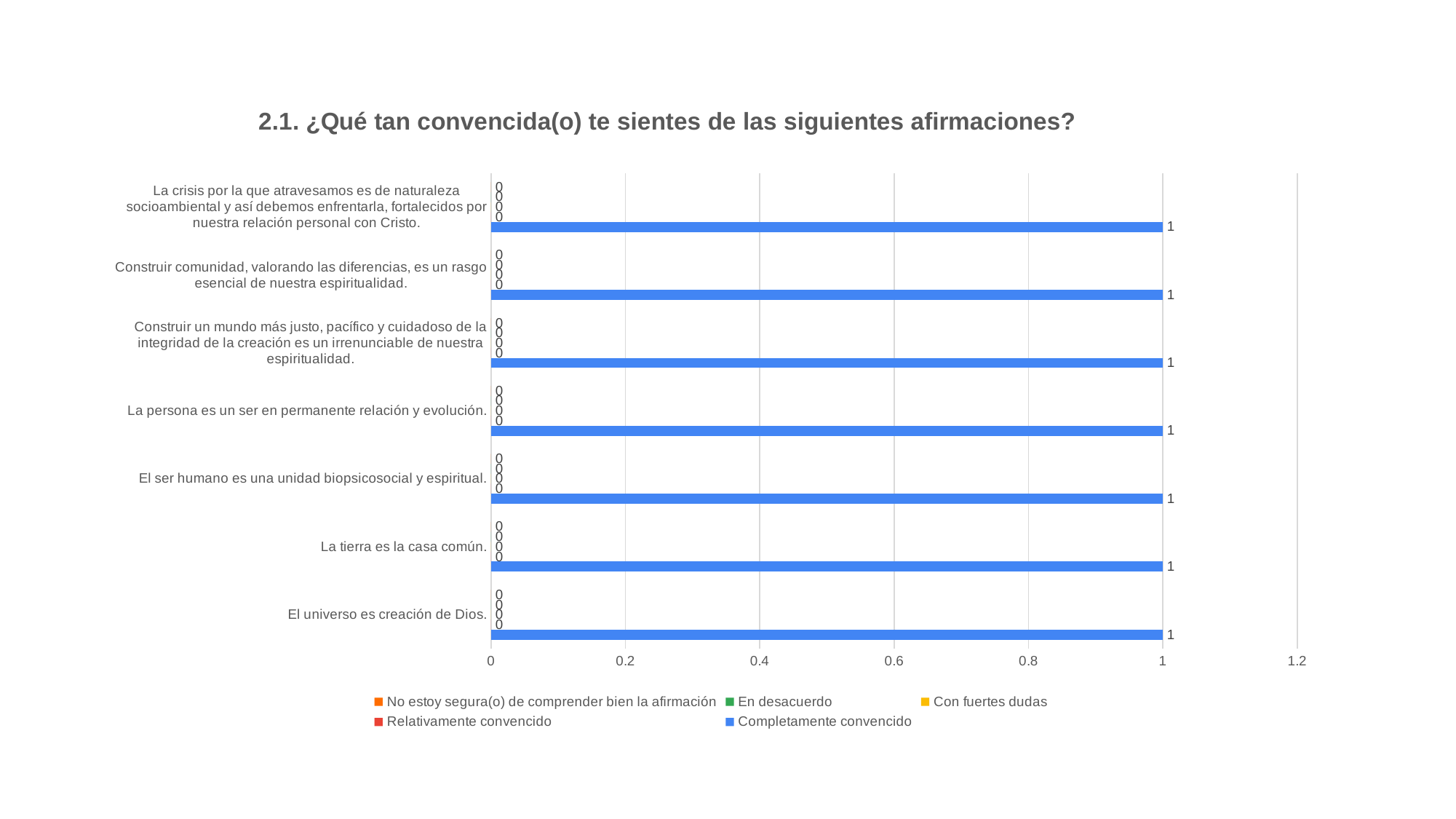
How many statements (categories) are listed on the vertical axis of the chart? 7 What is the value of "En desacuerdo" for "La persona es un ser en permanente relación y evolución."? 0 Is the "Completamente convencido" value for "La tierra es la casa común." greater or less than 0.8? greater What is the value of "Relativamente convencido" for "El ser humano es una unidad biopsicosocial y espiritual."? 0 Which colour represents the "Completamente convencido" series in the legend? blue How many series does the legend list? 5 What kind of chart is shown on the slide? bar chart What is the value of "Completamente convencido" for "El universo es creación de Dios."? 1 What is the title of the chart? 2.1. ¿Qué tan convencida(o) te sientes de las siguientes afirmaciones? What is the difference between the "Completamente convencido" value and the "No estoy segura(o) de comprender bien la afirmación" value for "El universo es creación de Dios."? 1 Which series has the larger value for "Construir comunidad, valorando las diferencias, es un rasgo esencial de nuestra espiritualidad.": "Completamente convencido" or "Con fuertes dudas"? Completamente convencido What is the value of "Completamente convencido" for "La tierra es la casa común."? 1